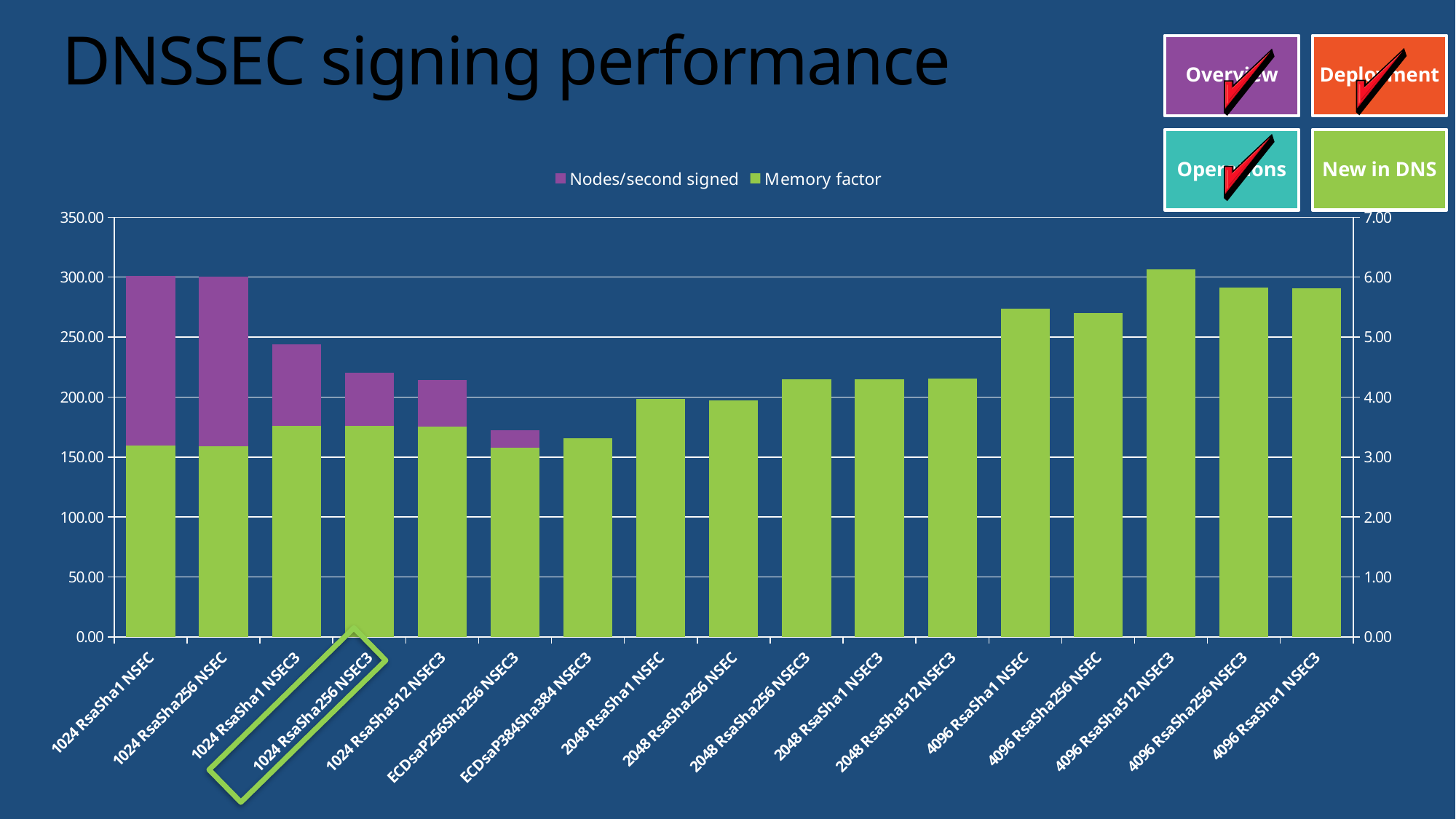
Which category has the highest Memory factor? 4096 RsaSha512 NSEC3 Which has the larger Nodes/second signed value, 1024 RsaSha1 NSEC3 or 1024 RsaSha256 NSEC3? 1024 RsaSha1 NSEC3 Which has the larger Memory factor, 4096 RsaSha1 NSEC or 2048 RsaSha1 NSEC? 4096 RsaSha1 NSEC Is the Memory factor for 4096 RsaSha512 NSEC3 greater or less than 6.00? greater Which category label on the x axis is highlighted with a green box? 1024 RsaSha256 NSEC3 How many series does the chart legend list? 2 Is the Memory factor for ECDsaP384Sha384 NSEC3 greater or less than 3.00? greater Is the Memory factor for 4096 RsaSha1 NSEC greater or less than 5.00? greater What kind of chart is shown on the slide? bar chart How many categories are shown along the x axis of the chart? 17